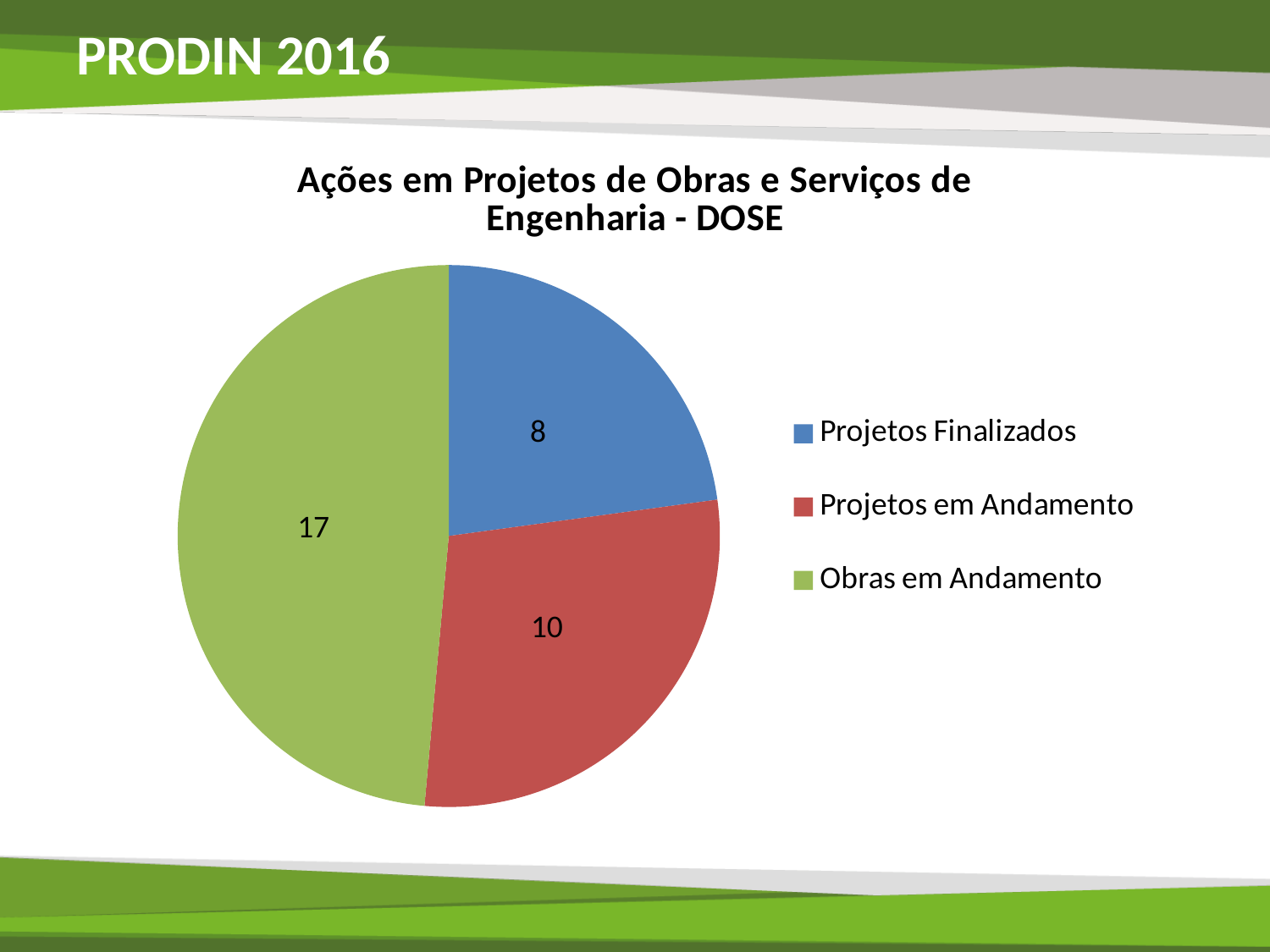
What is the value for Projetos Finalizados? 8 What kind of chart is shown on the slide? Pie chart Which category has the largest slice of the pie? Obras em Andamento How many categories does the pie chart show? 3 What is the value for Obras em Andamento? 17 What colour is the slice for Obras em Andamento? Green What is the title of the chart? Ações em Projetos de Obras e Serviços de Engenharia - DOSE Which category has the smallest slice of the pie? Projetos Finalizados Which is larger, Projetos em Andamento or Projetos Finalizados? Projetos em Andamento What is the value for Projetos em Andamento? 10 What is the difference between the values for Obras em Andamento and Projetos em Andamento? 7 What is the total of all slices in the pie chart? 35